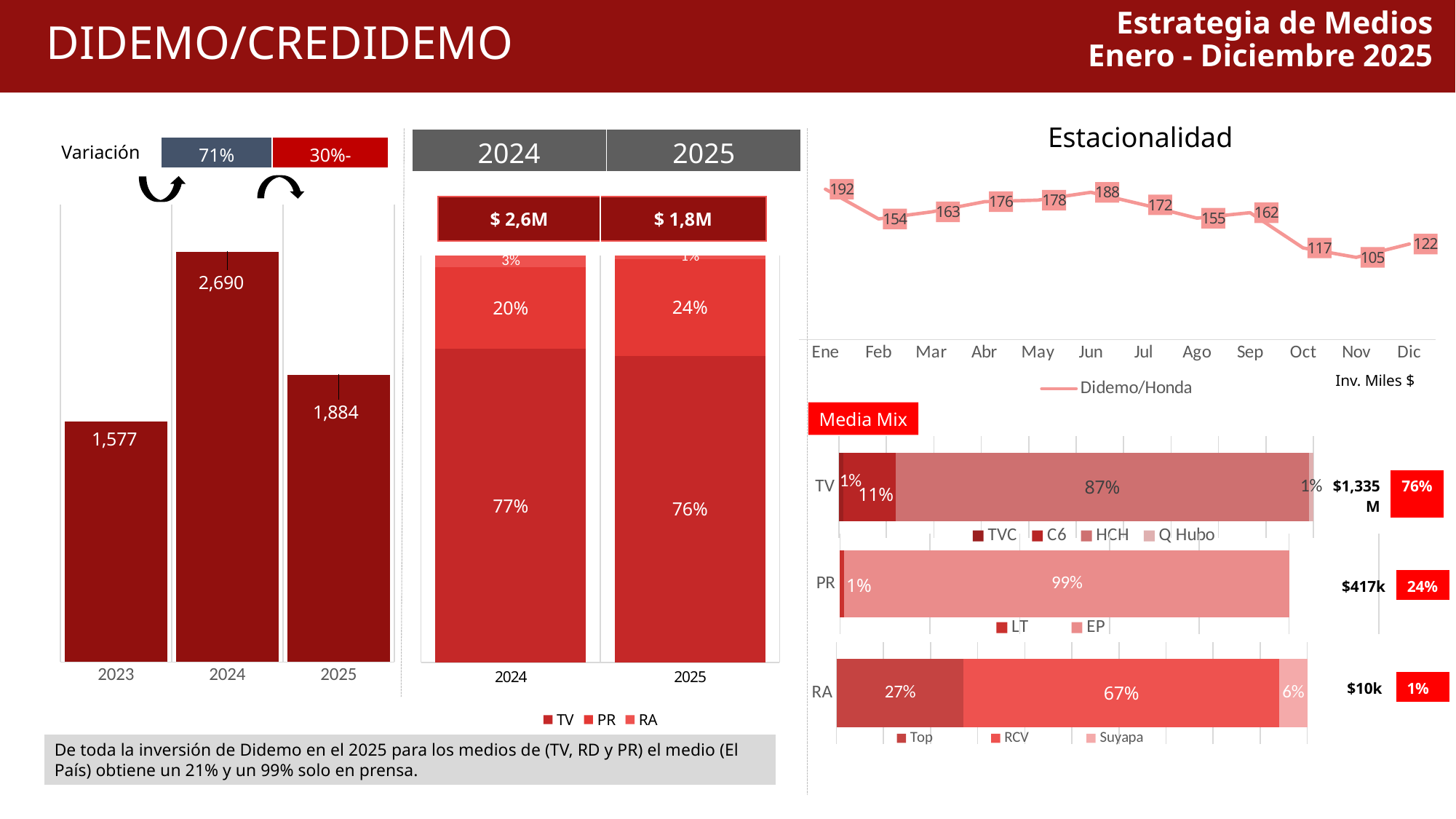
In the stacked bar chart in the middle of the slide, how many series does the legend list? 3 In the bar chart on the left of the slide, what is the value for 2024? 2,690 In the bar chart on the left of the slide, how many years are shown? 3 In the Estacionalidad line chart, which month has the lowest value? Nov In the stacked bar chart in the middle of the slide (2024 vs 2025), what share does TV have in 2025? 76% In the Estacionalidad line chart, what is the difference between the Ene and Dic values? 70 In the Estacionalidad line chart, what is the value for Jun? 188 In the Estacionalidad line chart, what series name does the legend show? Didemo/Honda In the bar chart on the left of the slide, what is the difference between the 2024 and 2025 values? 806 In the bar chart on the left of the slide, which year has the lowest value? 2023 In the Estacionalidad line chart, which month has the highest value? Ene In the Media Mix chart, what share does HCH have in the TV bar? 87%